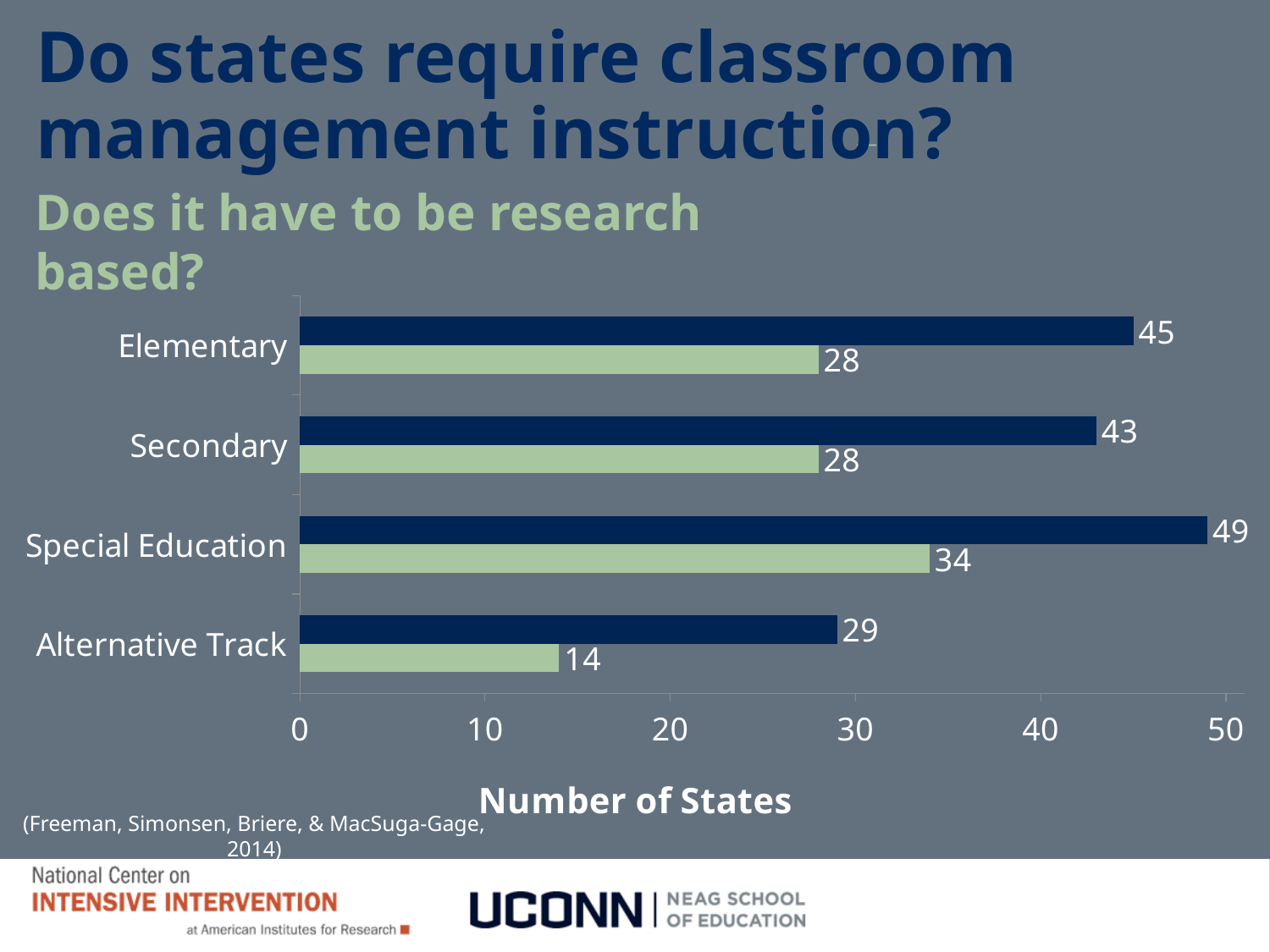
Which is larger: the dark blue bar for Alternative Track or the light green bar for Special Education? Light green bar for Special Education What kind of chart is shown on the slide? Bar chart What is the difference between the dark blue bars for Elementary and Secondary? 2 What is the value of the dark blue bar for Elementary? 45 Which category has the lowest light green bar? Alternative Track How many categories are shown on the chart? 4 What is the value of the light green bar for Alternative Track? 14 What is the value of the dark blue bar for Special Education? 49 Which category has the highest dark blue bar? Special Education What is the difference between the dark blue and light green bars for Special Education? 15 What is the value of the light green bar for Secondary? 28 What is the label of the horizontal axis? Number of States